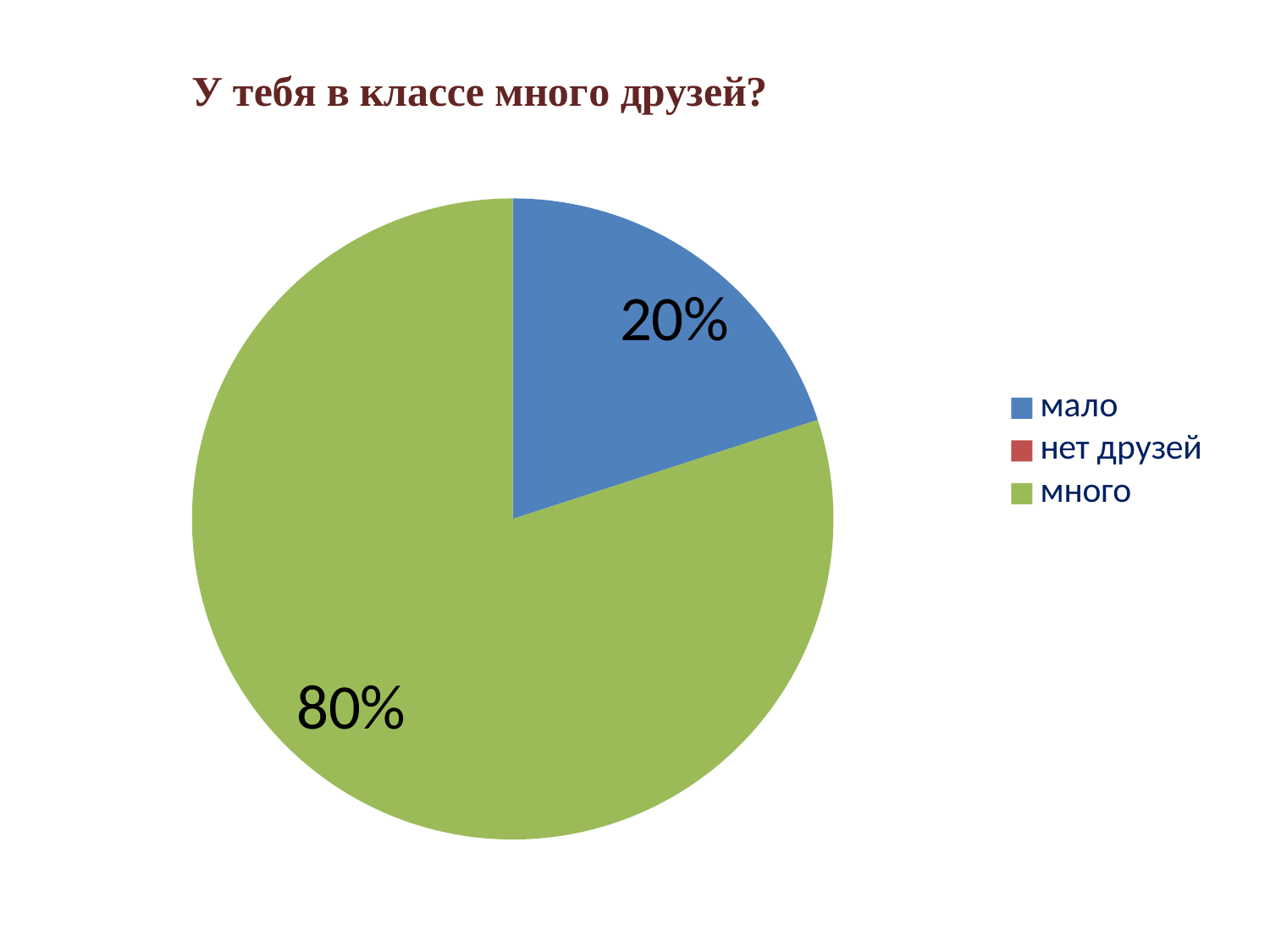
Is the share for "мало" greater or less than 50%? less What colour is the "много" slice? Green What is the difference in percentage points between the "много" and "мало" slices? 60% Which of the two visible slices is larger, "мало" or "много"? много What kind of chart is shown on the slide? Pie chart How many entries does the legend list? 3 Which legend entry has no visible slice in the pie? нет друзей What share of the pie does the "много" slice take? 80% What is the title of the chart? У тебя в классе много друзей? Which category has the largest slice of the pie? много What share of the pie does the "мало" slice take? 20%